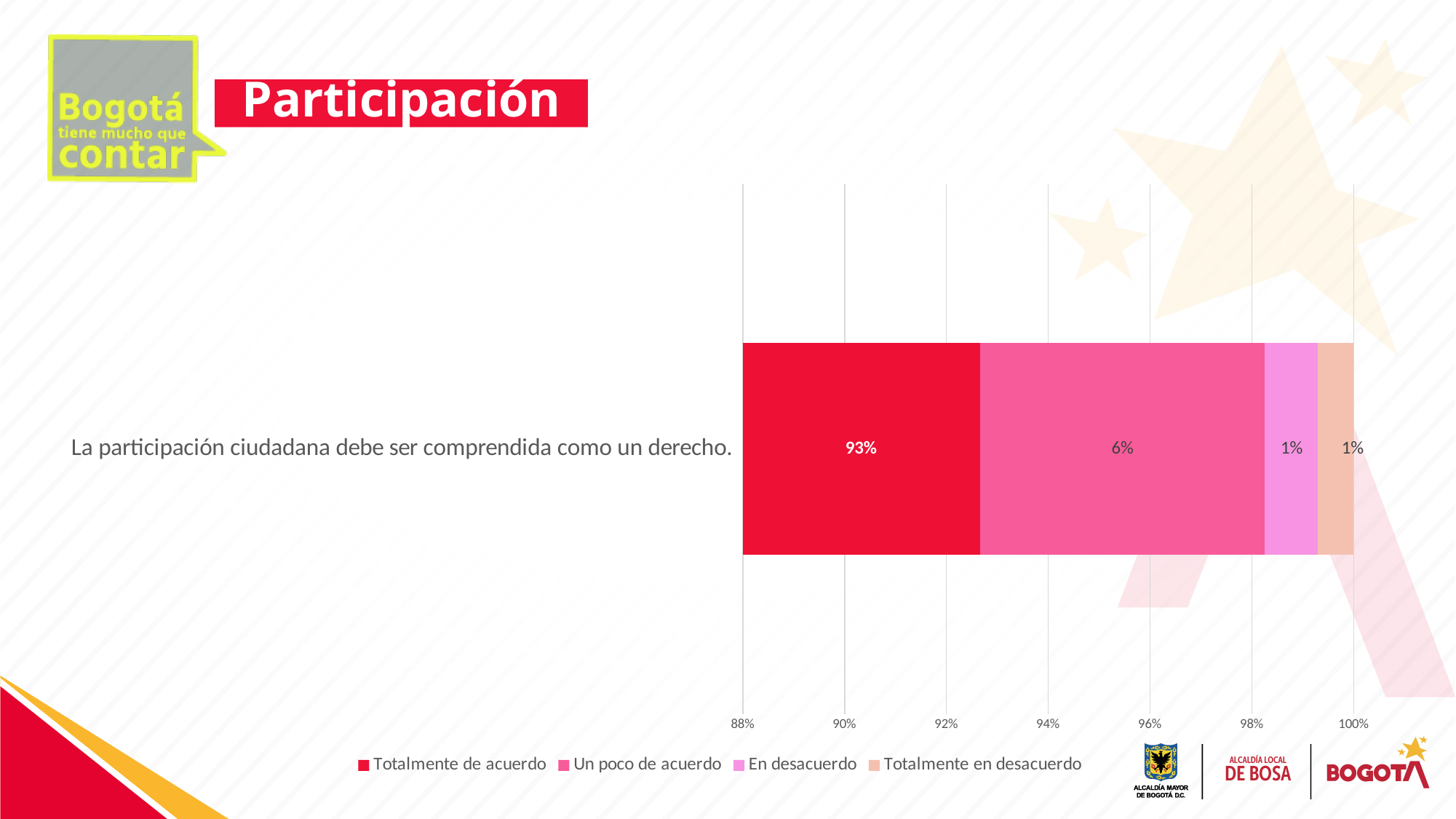
What is the difference in percentage points between "Totalmente de acuerdo" and "Un poco de acuerdo"? 87 percentage points Which response option has the highest percentage in the chart? Totalmente de acuerdo Which is larger, the value for "Totalmente de acuerdo" or the value for "Un poco de acuerdo"? Totalmente de acuerdo What kind of chart is shown on the slide? Stacked horizontal bar chart Is the value for "Totalmente de acuerdo" greater or less than 90%? greater How many statements (categories) are plotted in the chart? 1 What is the value shown for "En desacuerdo"? 1% What is the value shown for "Un poco de acuerdo"? 6% What is the value shown for "Totalmente en desacuerdo"? 1% What is the title shown at the top of the slide? Participación What percentage of respondents answered "Totalmente de acuerdo" to the statement "La participación ciudadana debe ser comprendida como un derecho"? 93% How many series does the legend list? 4